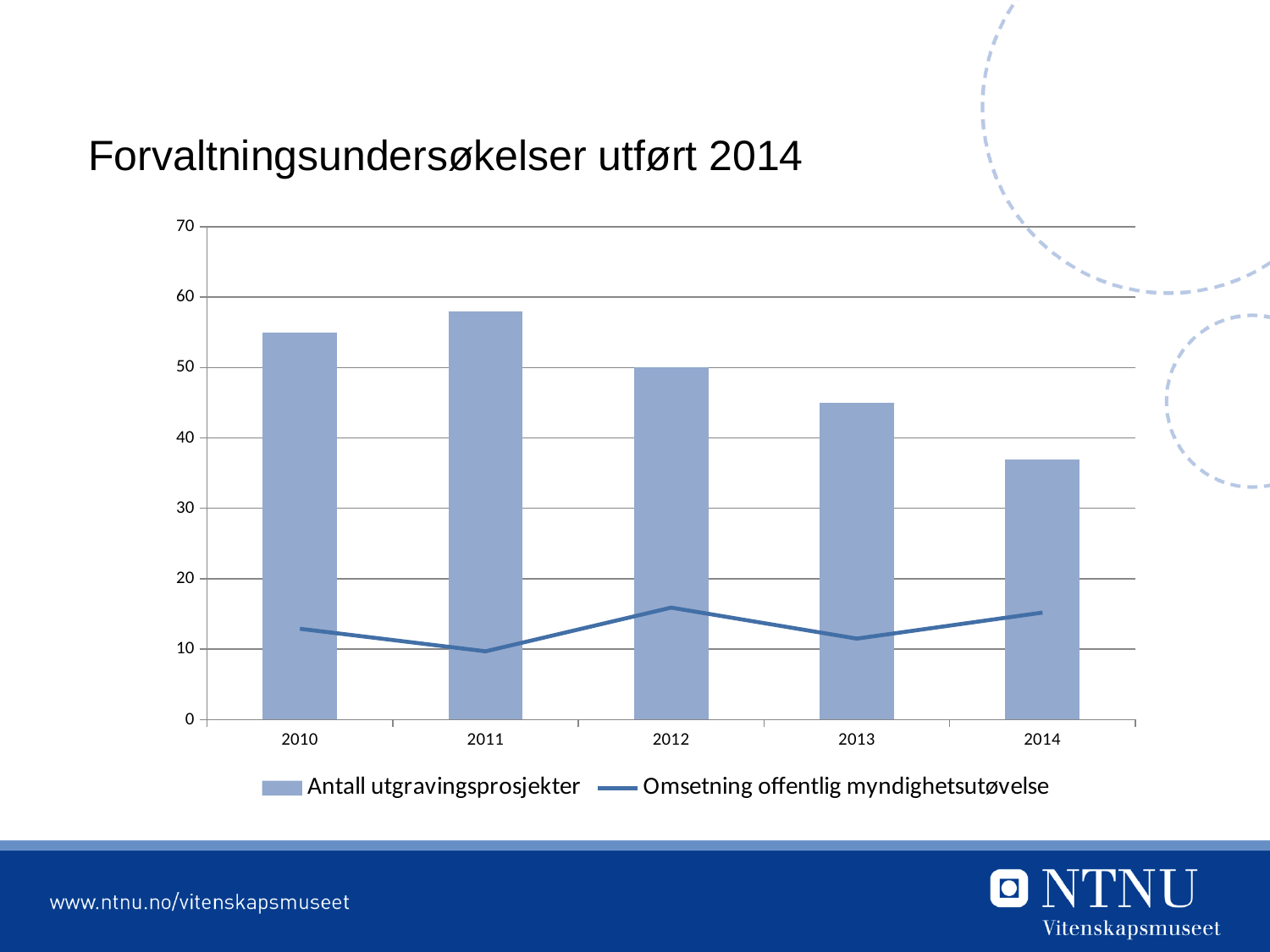
Which is larger, Antall utgravingsprosjekter in 2013 or in 2014? 2013 How many years are shown on the x axis? 5 Do the values for Antall utgravingsprosjekter rise or fall from 2011 to 2014? fall Which year has the highest value for Antall utgravingsprosjekter? 2011 What is the title of the slide? Forvaltningsundersøkelser utført 2014 Which year has the lowest value for Omsetning offentlig myndighetsutøvelse? 2011 What kind of chart is shown on the slide? A bar chart combined with a line chart Is the value for Antall utgravingsprosjekter in 2014 greater or less than 40? less Which year has the lowest value for Antall utgravingsprosjekter? 2014 Is the value for Antall utgravingsprosjekter in 2010 greater or less than 50? greater How many series does the legend list? 2 What is the value for Antall utgravingsprosjekter in 2012? 50